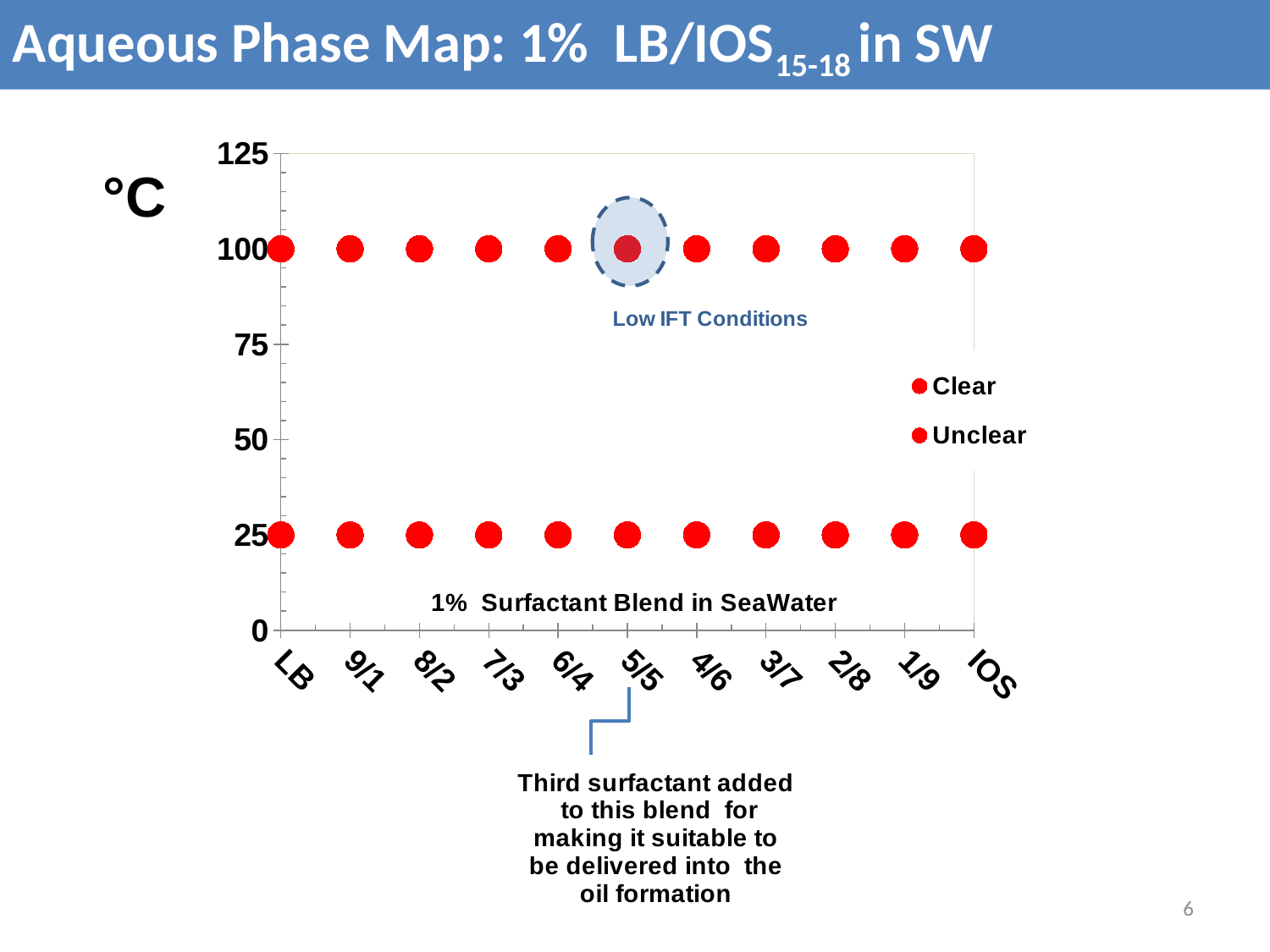
How many blend ratios are listed along the x axis of the chart? 11 Is the temperature of the upper row of points greater or less than 75? greater What is the temperature of the lower row of points for the LB blend? 25 At which two temperatures (°C) are the data points plotted in the chart? 25 and 100 What kind of chart is shown on the slide? scatter chart What is the x-axis title of the chart? 1% Surfactant Blend in SeaWater What is the difference in °C between the upper row of points and the lower row of points? 75 Is the temperature of the lower row of points greater or less than 50? less How many series does the chart's legend list? 2 What is the temperature of the upper row of points for the 5/5 blend? 100 Which blend ratio is circled and labelled 'Low IFT Conditions' in the chart? 5/5 Do the temperatures of the upper row of points rise, fall, or stay flat from LB to IOS along the x axis? stay flat